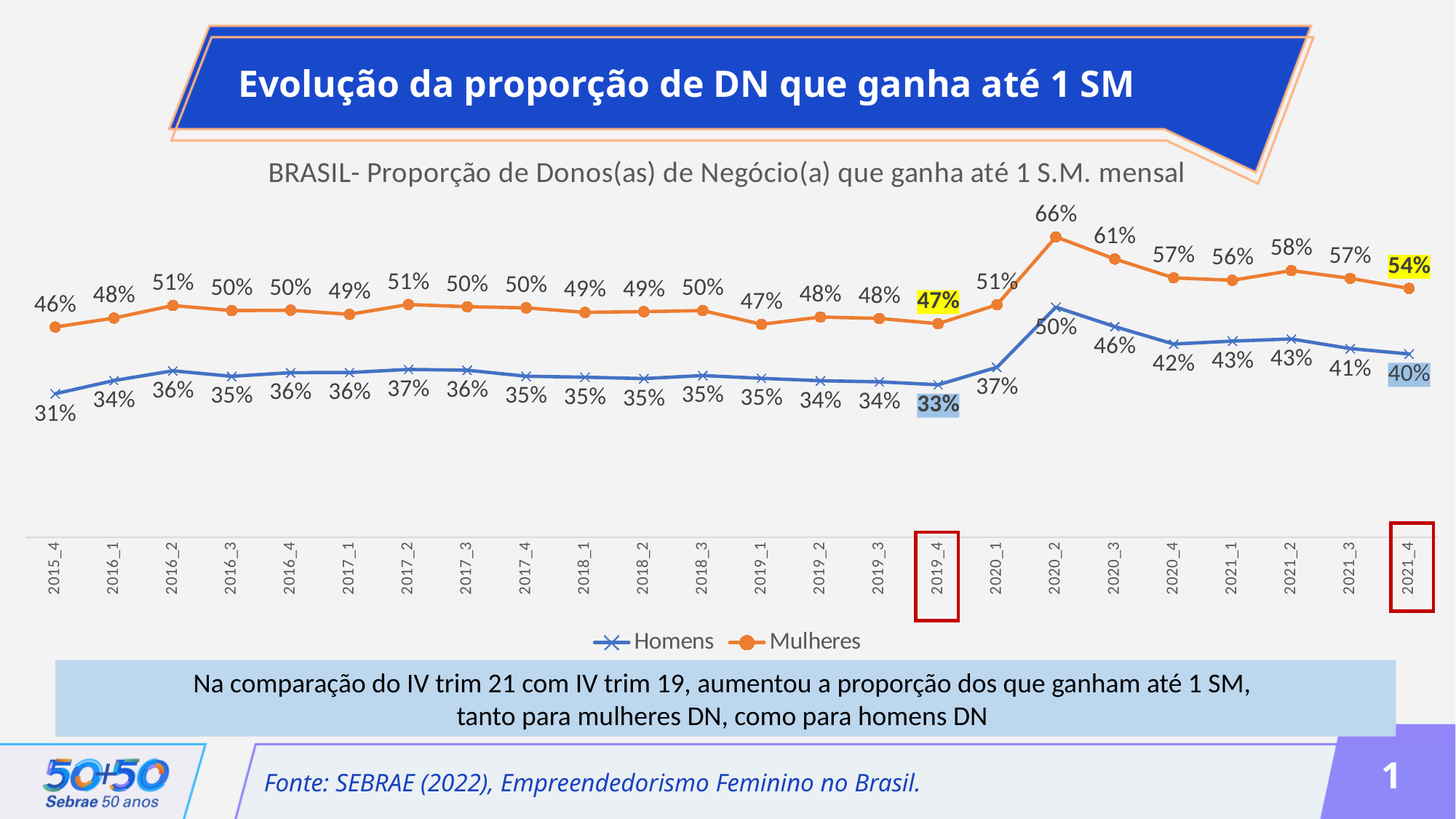
In which quarter does the Homens series reach its highest value? 2020_2 What is the value for Homens in 2019_4? 33% In which quarter does the Mulheres series have its lowest value? 2015_4 How many series does the legend list? 2 Which series has the higher value in 2020_3, Homens or Mulheres? Mulheres What is the value for Mulheres in 2021_4? 54% By how much did the Homens value change from 2019_4 to 2021_4? 7 percentage points What are the two series named in the legend? Homens and Mulheres What is the difference between the Mulheres and Homens values in 2021_4? 14 percentage points What is the value for Mulheres in 2020_2? 66% How many quarters (data points) are plotted along the x axis? 24 What type of chart is shown on the slide? line chart